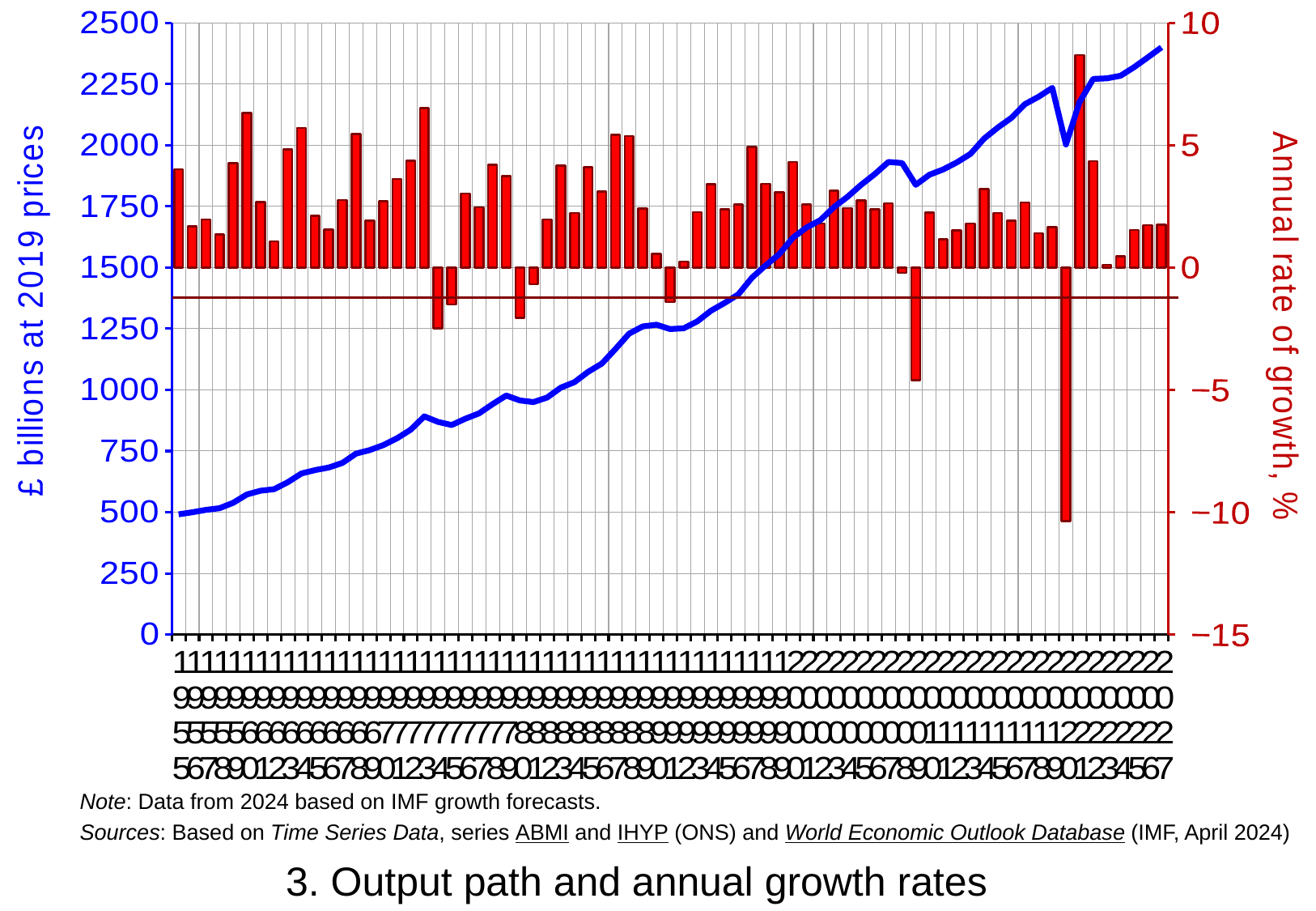
Is the annual rate of growth for 2020 greater or less than -5? less Does the output line (£ billions at 2019 prices) generally rise or fall from 1955 to 2027? rise Is the annual rate of growth for 2021 greater or less than 5? greater In which year is the annual rate of growth highest? 2021 What kind of chart is shown on the slide? A combined bar and line chart Is the annual rate of growth for 2009 greater or less than 0? less In which year is the annual rate of growth lowest? 2020 What does the left vertical axis measure? £ billions at 2019 prices Which is larger, the output in £ billions at 2019 prices in 1990 or in 1970? 1990 What is the title of the chart? 3. Output path and annual growth rates